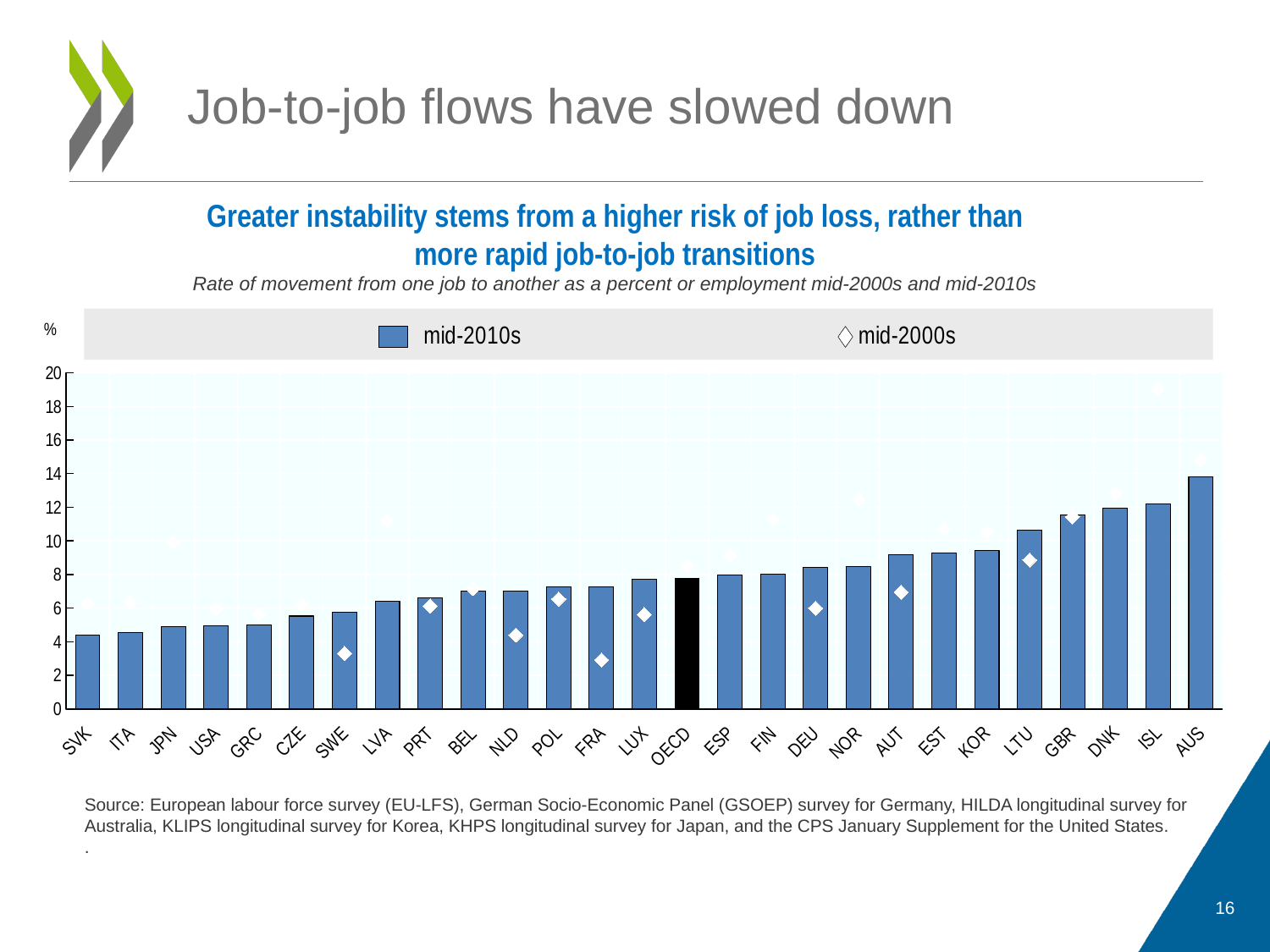
Which category has the highest mid-2010s bar? AUS Do the mid-2010s bars generally rise or fall from left to right along the x axis? rise Is the mid-2010s value for SVK greater or less than 6? less Is the mid-2010s value for AUS greater or less than 12? greater What kind of chart is shown on the slide? bar chart How many countries/categories are shown on the x axis? 27 Which category has the lowest mid-2010s bar? SVK How many series does the legend list? 2 Is the mid-2010s value for ISL greater or less than 10? greater Which has the larger mid-2010s bar, DNK or ITA? DNK Which bar is coloured black rather than blue? OECD